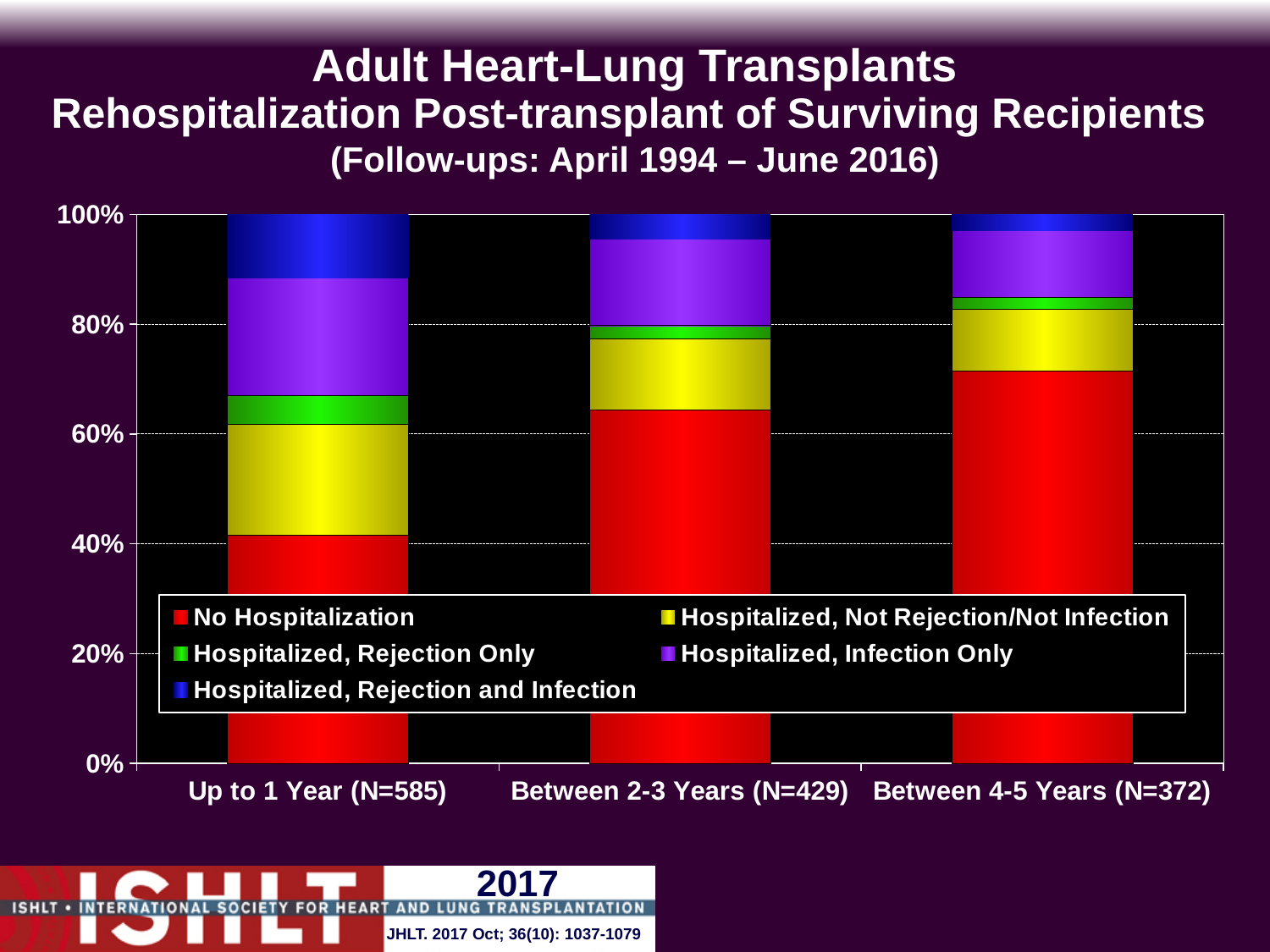
Which colour represents Hospitalized, Infection Only in the legend? Purple Is the No Hospitalization share for Between 4-5 Years (N=372) greater or less than 60%? greater Is the No Hospitalization share for Between 2-3 Years (N=429) greater or less than 60%? greater How many series does the legend list? 5 Which has the larger Hospitalized, Rejection and Infection share: Up to 1 Year (N=585) or Between 4-5 Years (N=372)? Up to 1 Year (N=585) Which follow-up category has the largest No Hospitalization share? Between 4-5 Years (N=372) What kind of chart is shown on the slide? Stacked bar chart Does the No Hospitalization share rise or fall from Up to 1 Year to Between 4-5 Years? rise What is the total height of each stacked bar? 100% How many follow-up categories are shown on the x axis? 3 Is the No Hospitalization share for Up to 1 Year (N=585) greater or less than 60%? less Which follow-up category has the smallest No Hospitalization share? Up to 1 Year (N=585)